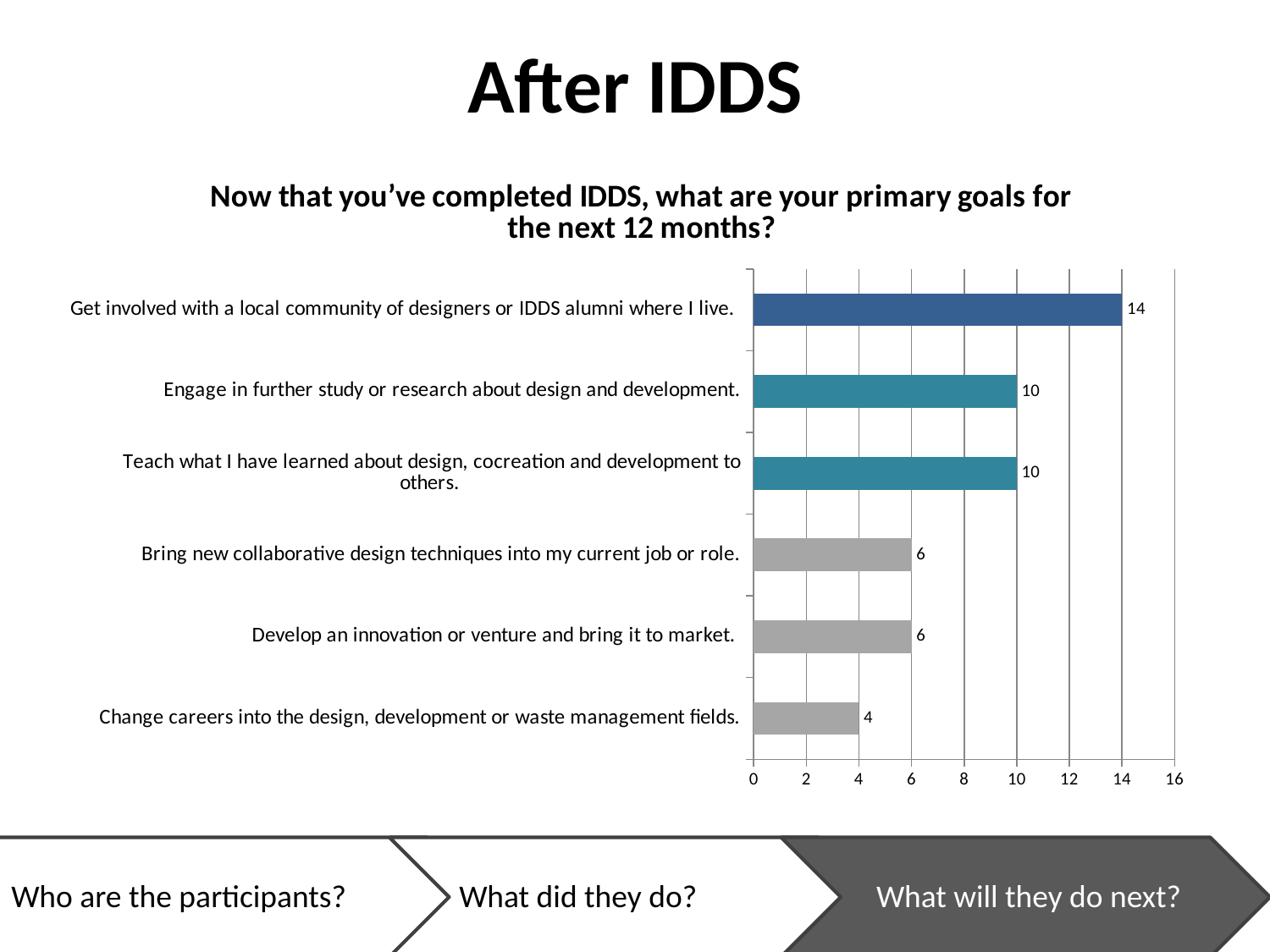
What is the difference between the values for "Get involved with a local community of designers or IDDS alumni where I live." and "Change careers into the design, development or waste management fields."? 10 What is the maximum value shown on the horizontal axis? 16 What kind of chart is shown on the slide? bar chart Which category has the highest value? Get involved with a local community of designers or IDDS alumni where I live. How many categories are shown in the chart? 6 Is the value for "Get involved with a local community of designers or IDDS alumni where I live." greater or less than 12? greater What is the value for "Change careers into the design, development or waste management fields."? 4 What is the value for "Get involved with a local community of designers or IDDS alumni where I live."? 14 Which category has the lowest value? Change careers into the design, development or waste management fields. Which is larger: the value for "Engage in further study or research about design and development." or the value for "Bring new collaborative design techniques into my current job or role."? Engage in further study or research about design and development. What is the difference between the values for "Teach what I have learned about design, cocreation and development to others." and "Develop an innovation or venture and bring it to market."? 4 What is the value for "Engage in further study or research about design and development."? 10